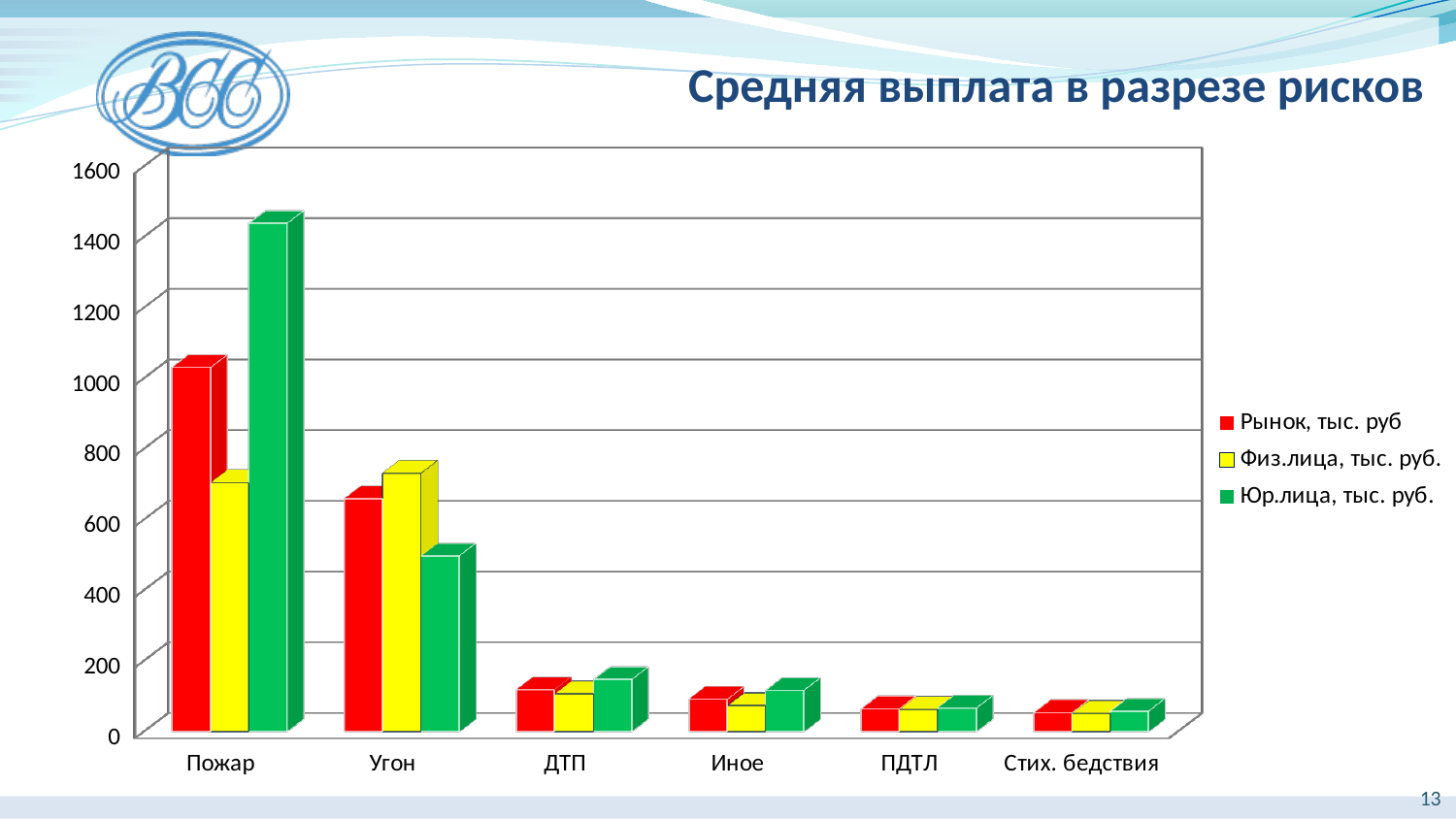
For Пожар, which is larger: the Рынок, тыс. руб value or the Физ.лица, тыс. руб. value? Рынок, тыс. руб Do the Рынок, тыс. руб values generally rise or fall from left to right along the x axis? fall Which category has the lowest value for the Рынок, тыс. руб series? Стих. бедствия What is the title of the chart on the slide? Средняя выплата в разрезе рисков Is the Юр.лица, тыс. руб. value for Угон greater or less than 600? less Is the Юр.лица, тыс. руб. value for Пожар greater or less than 1200? greater Which category has the highest value for the Юр.лица, тыс. руб. series? Пожар How many series does the legend list? 3 What kind of chart is shown on the slide? bar chart Which category has the highest value for the Рынок, тыс. руб series? Пожар How many categories are shown on the x axis of the chart? 6 For Угон, which is larger: the Физ.лица, тыс. руб. value or the Юр.лица, тыс. руб. value? Физ.лица, тыс. руб.